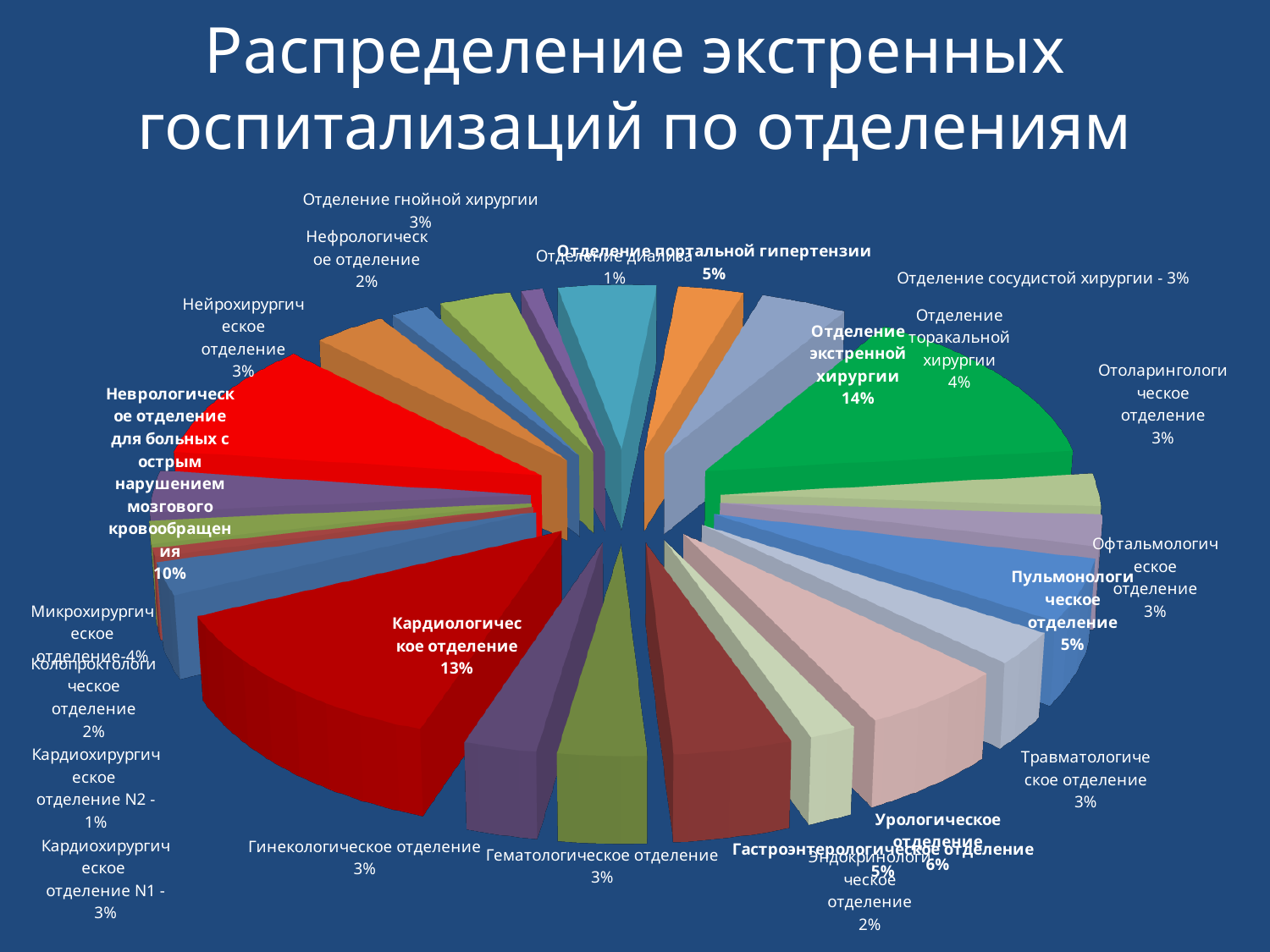
What is the share for Отделение диализа? 1% What is the share for Неврологическое отделение для больных с острым нарушением мозгового кровообращения? 10% What is the share for Урологическое отделение? 6% Which department has the largest share of emergency hospitalizations? Отделение экстренной хирургии What share of emergency hospitalizations does Кардиологическое отделение account for? 13% What share of emergency hospitalizations does Отделение экстренной хирургии account for? 14% What is the share for Отделение торакальной хирургии? 4% What is the title of the chart? Распределение экстренных госпитализаций по отделениям What is the share for Отделение портальной гипертензии? 5% What kind of chart is shown on the slide? pie chart Which has a larger share, Урологическое отделение or Пульмонологическое отделение? Урологическое отделение By how many percentage points does Отделение экстренной хирургии exceed Кардиологическое отделение? 1 percentage point